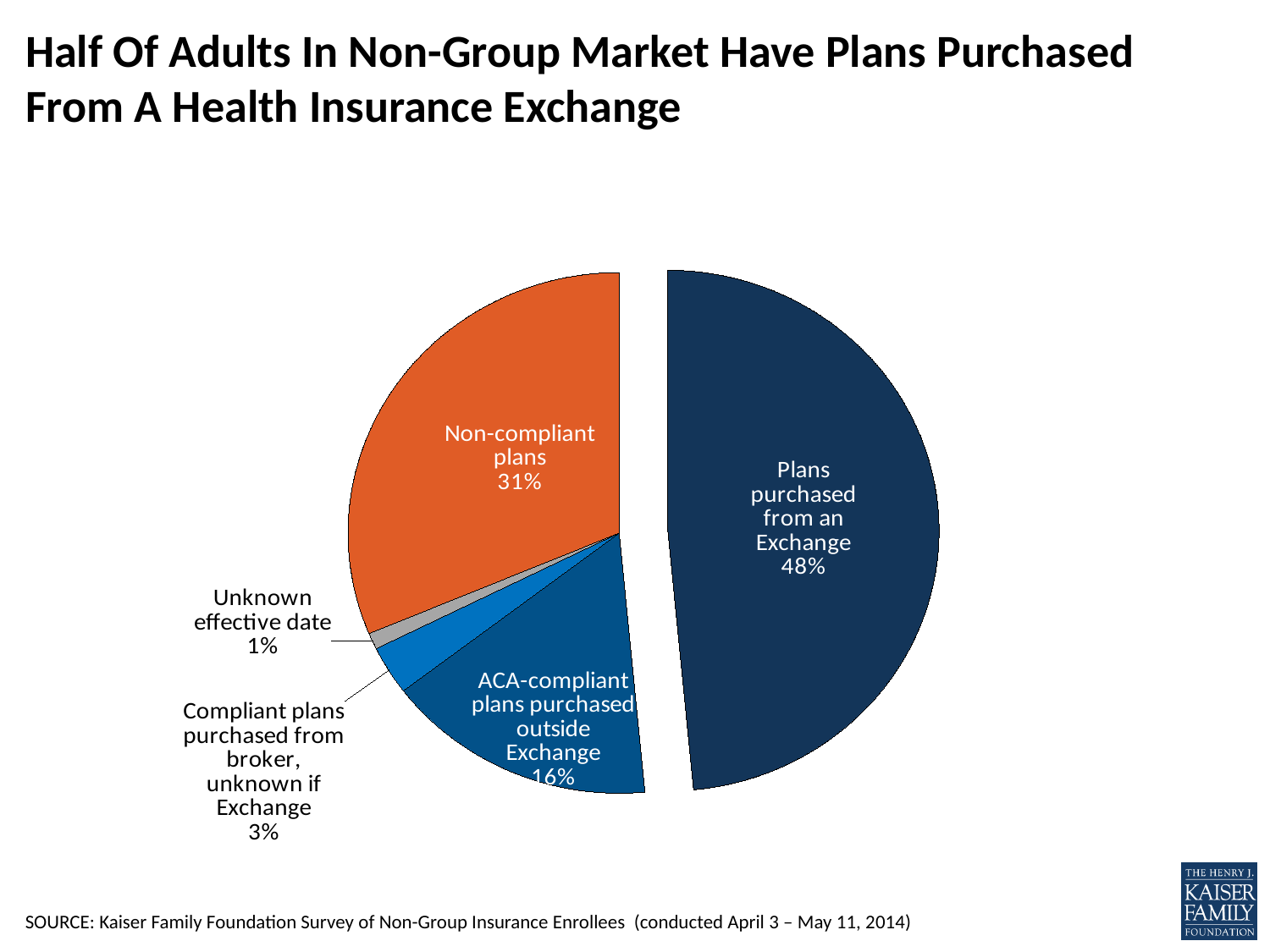
Which is larger: the share of non-compliant plans or the share of ACA-compliant plans purchased outside Exchange? Non-compliant plans Which slice of the pie is the smallest? Unknown effective date What percentage is shown for the unknown effective date slice? 1% Which slice of the pie is the largest? Plans purchased from an Exchange What percentage is shown for compliant plans purchased from broker, unknown if Exchange? 3% What is the difference between the share of plans purchased from an Exchange and the share of non-compliant plans? 17 percentage points What share is shown for ACA-compliant plans purchased outside Exchange? 16% What percentage of adults have non-compliant plans? 31% Which slice is separated (exploded) from the rest of the pie? Plans purchased from an Exchange How many slices does the pie chart have? 5 What share of adults have plans purchased from an Exchange? 48% What kind of chart is shown on the slide? pie chart